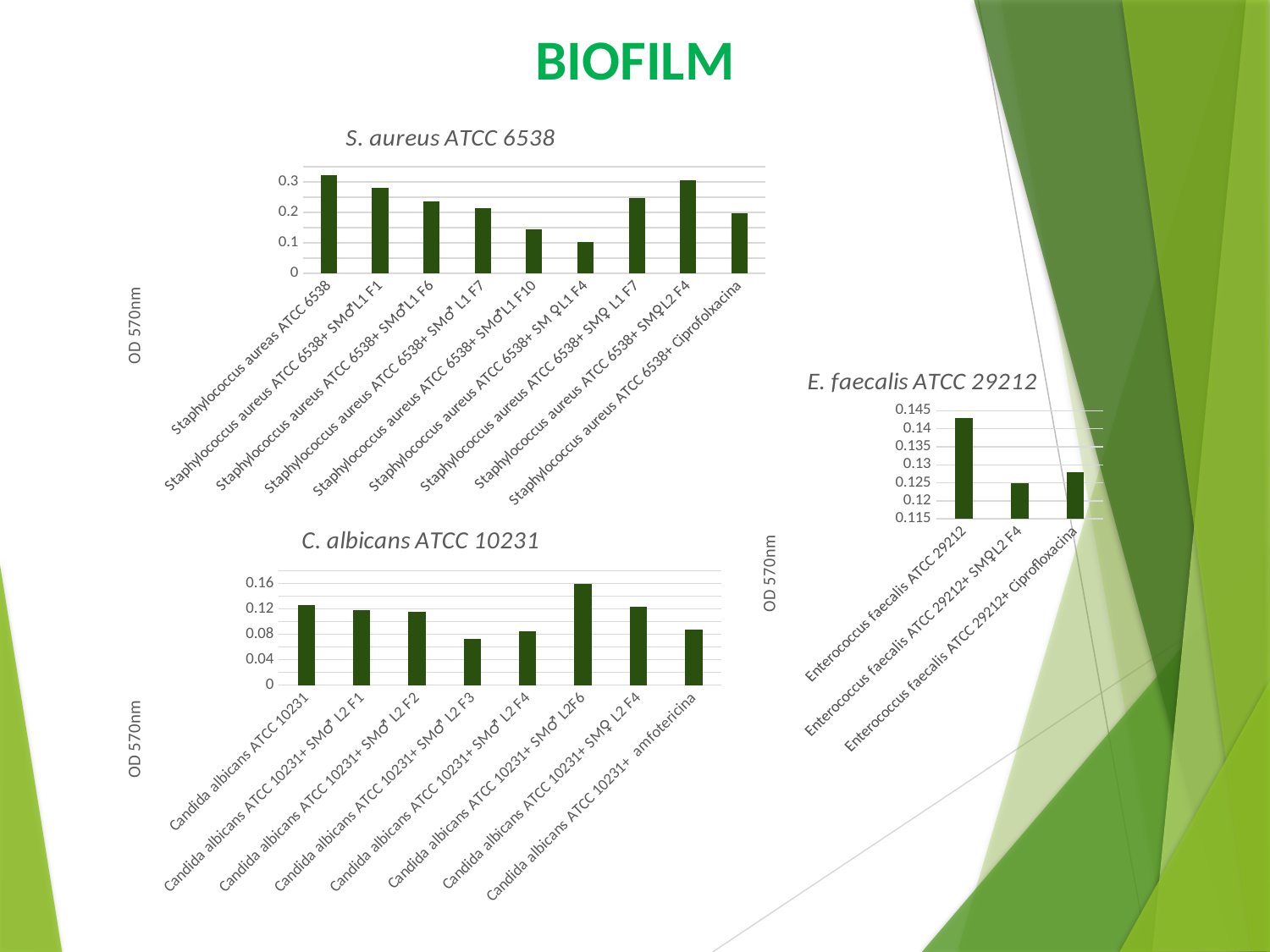
In the C. albicans ATCC 10231 chart, is the value for Candida albicans ATCC 10231+ amfotericina greater or less than 0.08? greater In the S. aureus ATCC 6538 chart, which category has the lowest value? Staphylococcus aureus ATCC 6538+ SM ♀L1 F4 In the S. aureus ATCC 6538 chart, how many bars are plotted? 9 In the C. albicans ATCC 10231 chart, how many categories are shown? 8 In the S. aureus ATCC 6538 chart, is the value for Staphylococcus aureus ATCC 6538+ SMσL1 F10 greater or less than 0.1? greater In the E. faecalis ATCC 29212 chart, which category has the highest value? Enterococcus faecalis ATCC 29212 In the E. faecalis ATCC 29212 chart, how many bars are plotted? 3 In the C. albicans ATCC 10231 chart, which category has the highest value? Candida albicans ATCC 10231+ SMσ L2F6 What is the y-axis label on the S. aureus ATCC 6538 chart? OD 570nm In the S. aureus ATCC 6538 chart, which is larger: the value for Staphylococcus aureus ATCC 6538+ SMσL1 F1 or for Staphylococcus aureus ATCC 6538+ SMσL1 F6? Staphylococcus aureus ATCC 6538+ SMσL1 F1 What type of chart is the E. faecalis ATCC 29212 chart? bar chart In the C. albicans ATCC 10231 chart, which category has the lowest value? Candida albicans ATCC 10231+ SMσ L2 F3